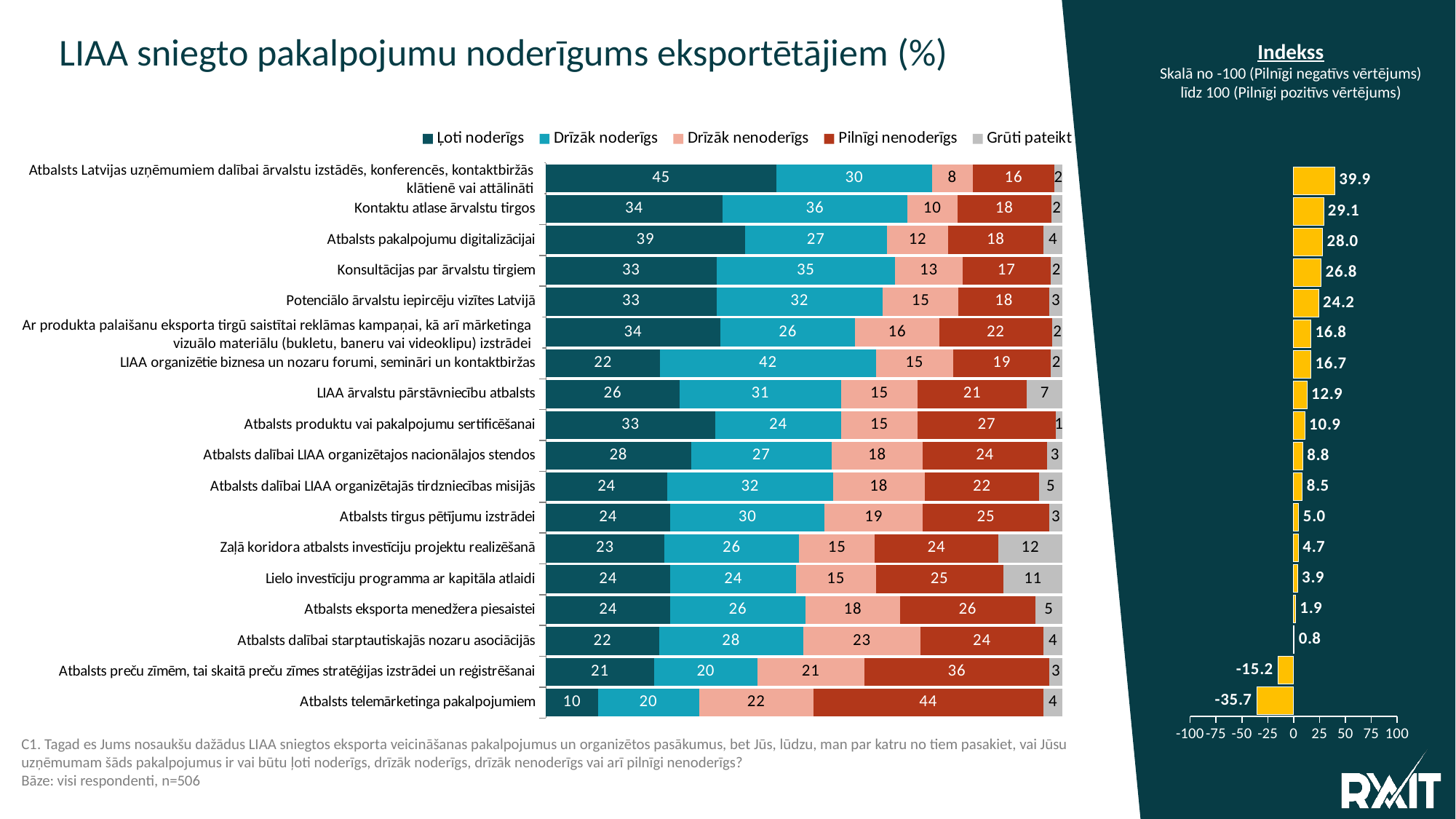
In the stacked bar chart on the left, what is the 'Ļoti noderīgs' value for 'Kontaktu atlase ārvalstu tirgos'? 34 In the stacked bar chart on the left, which is larger: the 'Grūti pateikt' value for 'Zaļā koridora atbalsts investīciju projektu realizēšanā' or for 'Lielo investīciju programma ar kapitāla atlaidi'? Zaļā koridora atbalsts investīciju projektu realizēšanā How many categories are shown in the stacked bar chart on the left? 18 In the stacked bar chart on the left, which category has the highest 'Ļoti noderīgs' value? Atbalsts Latvijas uzņēmumiem dalībai ārvalstu izstādēs, konferencēs, kontaktbiržās klātienē vai attālināti In the 'Indekss' chart on the right, how many categories have a negative index value? 2 What kind of chart is the 'Indekss' chart on the right? Bar chart How many series does the legend of the stacked bar chart on the left list? 5 In the stacked bar chart on the left, which category has the lowest 'Ļoti noderīgs' value? Atbalsts telemārketinga pakalpojumiem In the 'Indekss' chart on the right, which category has the lowest index value? Atbalsts telemārketinga pakalpojumiem In the 'Indekss' chart on the right, what is the index value for 'Atbalsts pakalpojumu digitalizācijai'? 28.0 In the stacked bar chart on the left, what is the difference between the 'Drīzāk noderīgs' values for 'LIAA organizētie biznesa un nozaru forumi, semināri un kontaktbiržas' and 'Atbalsts preču zīmēm, tai skaitā preču zīmes stratēģijas izstrādei un reģistrēšanai'? 22 In the stacked bar chart on the left, what is the 'Pilnīgi nenoderīgs' value for 'Atbalsts telemārketinga pakalpojumiem'? 44